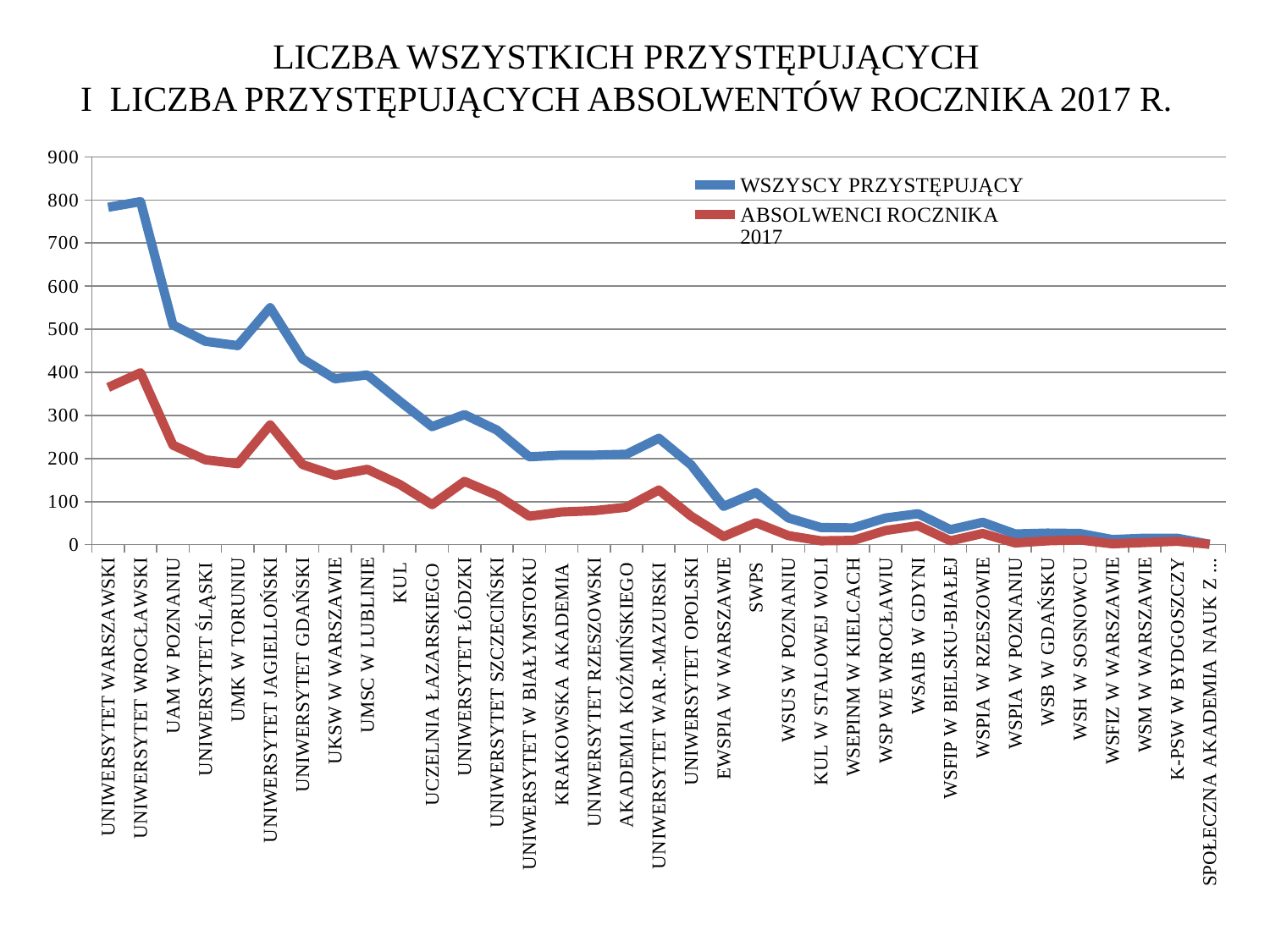
Which has the larger WSZYSCY PRZYSTĘPUJĄCY value, UNIWERSYTET JAGIELLOŃSKI or UNIWERSYTET GDAŃSKI? UNIWERSYTET JAGIELLOŃSKI Is the WSZYSCY PRZYSTĘPUJĄCY value for UNIWERSYTET JAGIELLOŃSKI greater or less than 500? greater What kind of chart is shown on the slide? line chart Do the values generally rise or fall moving from left to right along the x axis? fall Which colour is used for the ABSOLWENCI ROCZNIKA 2017 series? red Is the ABSOLWENCI ROCZNIKA 2017 value for UNIWERSYTET JAGIELLOŃSKI greater or less than 300? less Is the WSZYSCY PRZYSTĘPUJĄCY value for UNIWERSYTET WARSZAWSKI greater or less than 700? greater How many series does the legend list? 2 Which institution has the highest value for WSZYSCY PRZYSTĘPUJĄCY? UNIWERSYTET WROCŁAWSKI How many institutions (categories) are plotted along the x axis? 35